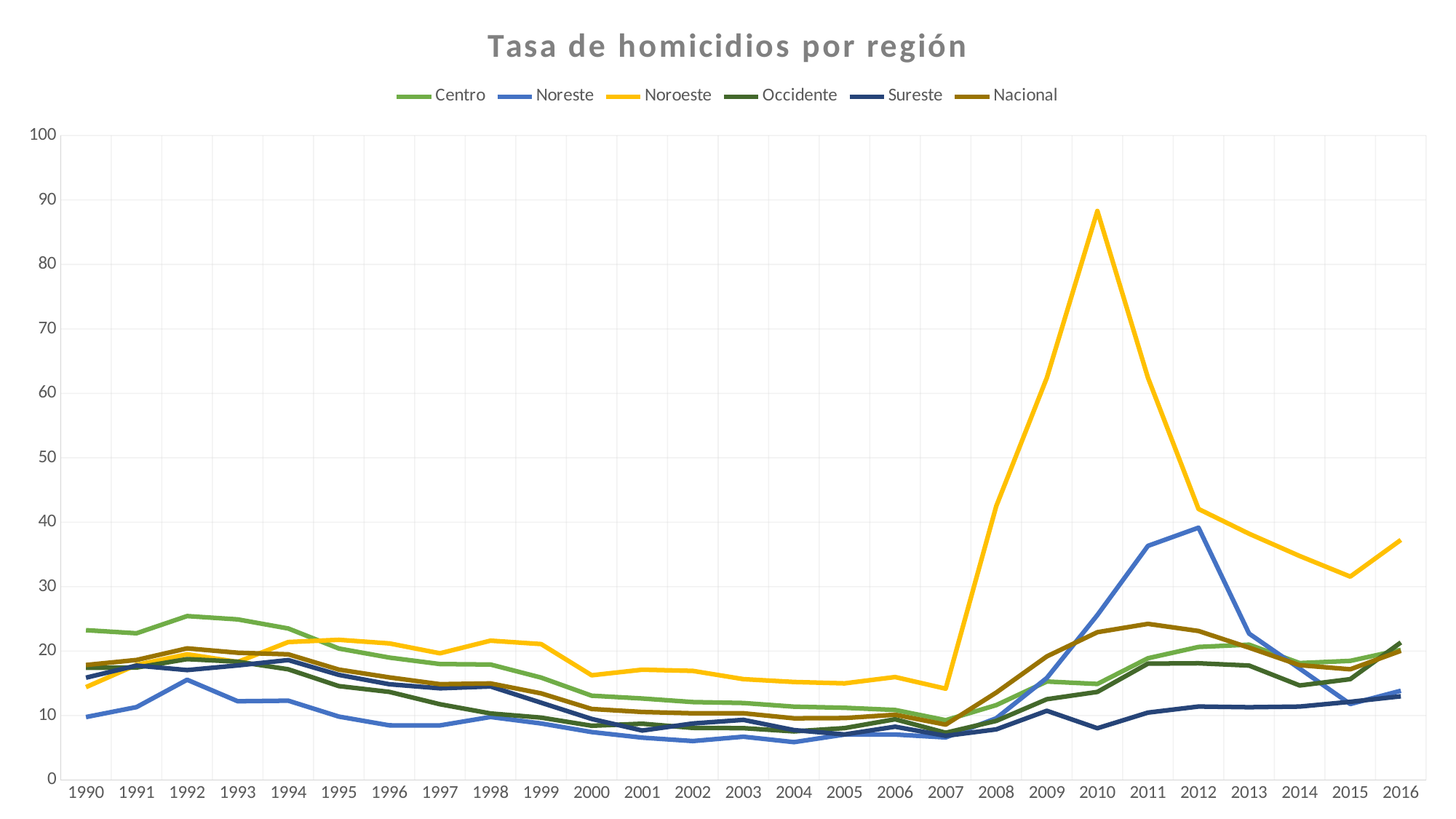
Is the value for Noroeste in 2010 greater or less than 80? greater What is the title of the chart? Tasa de homicidios por región Which region has the highest homicide rate in 2010? Noroeste How many series does the legend list? 6 Does the Noroeste line rise or fall between 2010 and 2015? fall How many years are plotted along the x axis? 27 In 2016, which is larger: the value for Centro or the value for Sureste? Centro Is the value for Sureste in 2010 greater or less than 10? less Is the value for Noreste in 2012 greater or less than 30? greater Which region has the highest homicide rate in 1990? Centro Which region has the lowest homicide rate in 1990? Noreste What kind of chart is shown on the slide? line chart